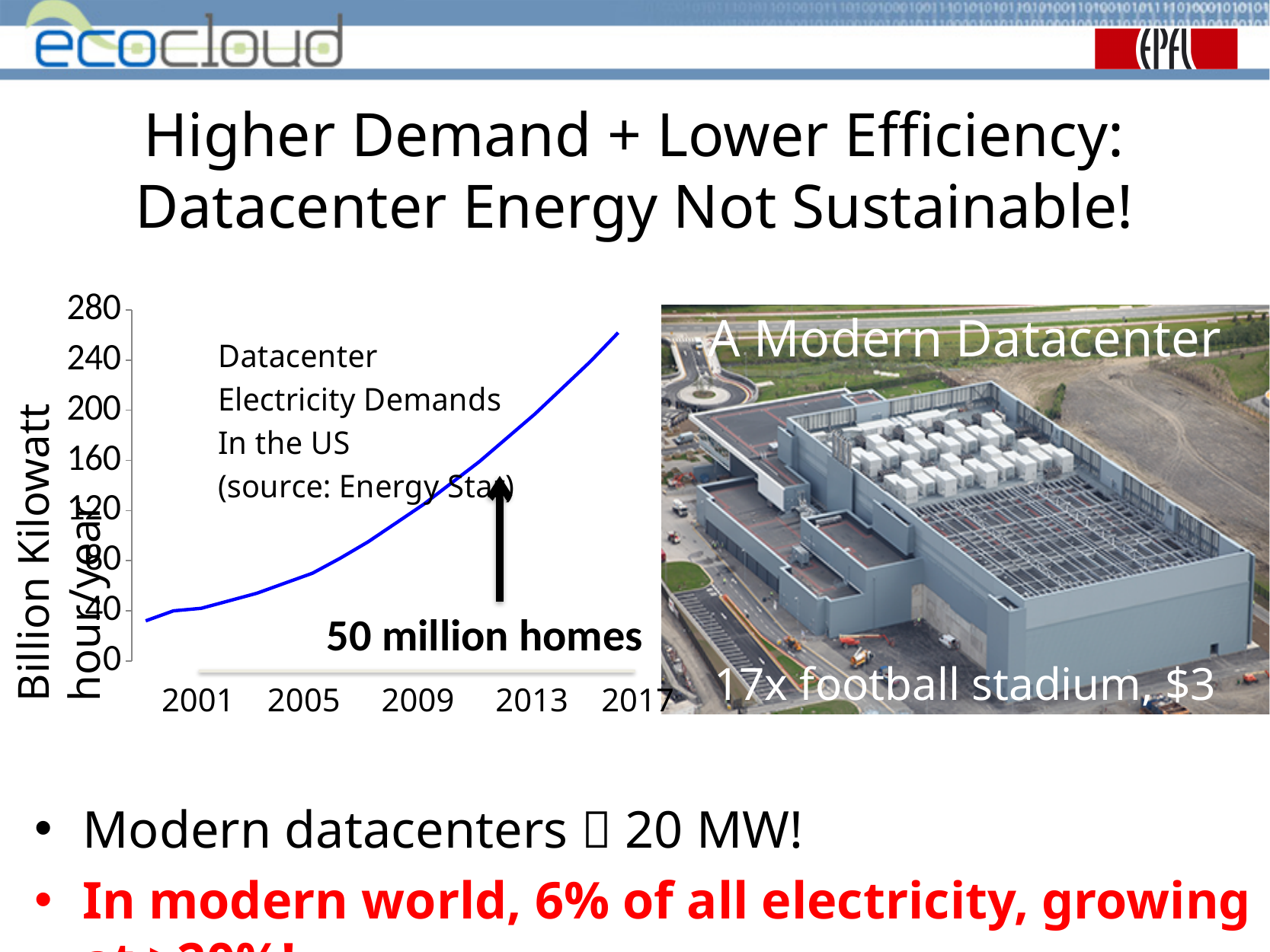
Which year shown on the x axis has the lowest electricity demand? 2001 Is the value for 2005 greater or less than 80? less Is the value for 2001 greater or less than 40? less What kind of chart is shown on the slide? line chart What is the unit shown on the y axis of the chart? Billion Kilowatt hours/year Is the value for 2013 greater or less than 120? greater Does datacenter electricity demand rise or fall from 2001 to 2017 in the chart? rise How many year labels are shown on the x axis of the chart? 5 Which is larger, the value for 2013 or the value for 2005? 2013 Which year shown on the x axis has the highest electricity demand? 2017